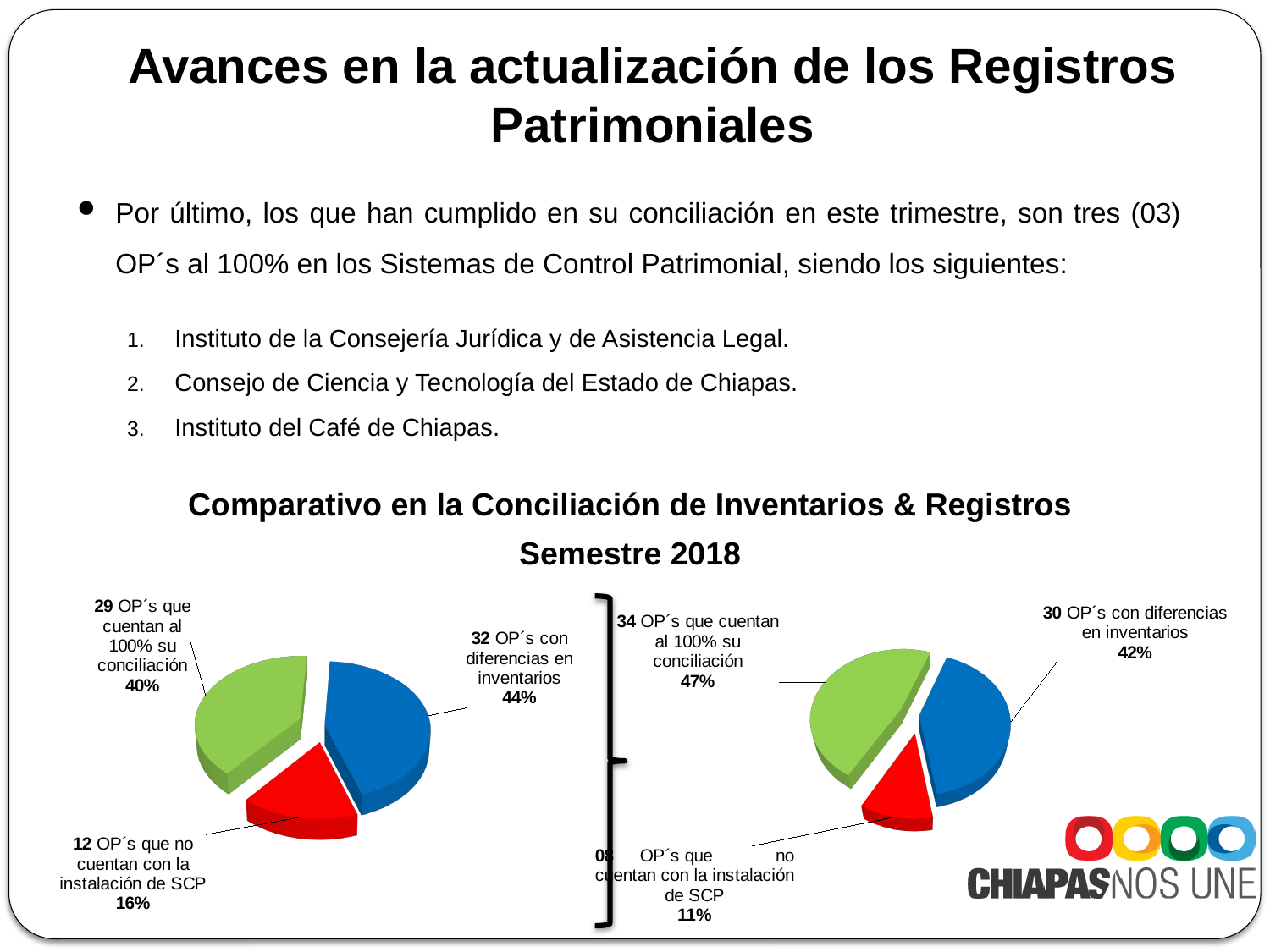
In the left pie chart, how many OP's cuentan al 100% su conciliación? 29 In the left pie chart, which slice has the largest share? OP's con diferencias en inventarios In the left pie chart, what percentage is shown for the OP's con diferencias en inventarios slice? 44% What is the difference in the number of OP's que no cuentan con la instalación de SCP between the left pie chart (12) and the right pie chart (08)? 4 In the right pie chart, what percentage is shown for the OP's que no cuentan con la instalación de SCP? 11% How many slices does the right pie chart have? 3 In the right pie chart, what percentage is shown for the OP's que cuentan al 100% su conciliación? 47% What kind of chart is shown on the left side of the slide? Pie chart In the right pie chart, which slice has the smallest share? OP's que no cuentan con la instalación de SCP In the right pie chart, how many OP's con diferencias en inventarios are there? 30 In the left pie chart, what percentage is shown for the OP's que no cuentan con la instalación de SCP? 16% What is the title shown above the two pie charts? Comparativo en la Conciliación de Inventarios & Registros Semestre 2018